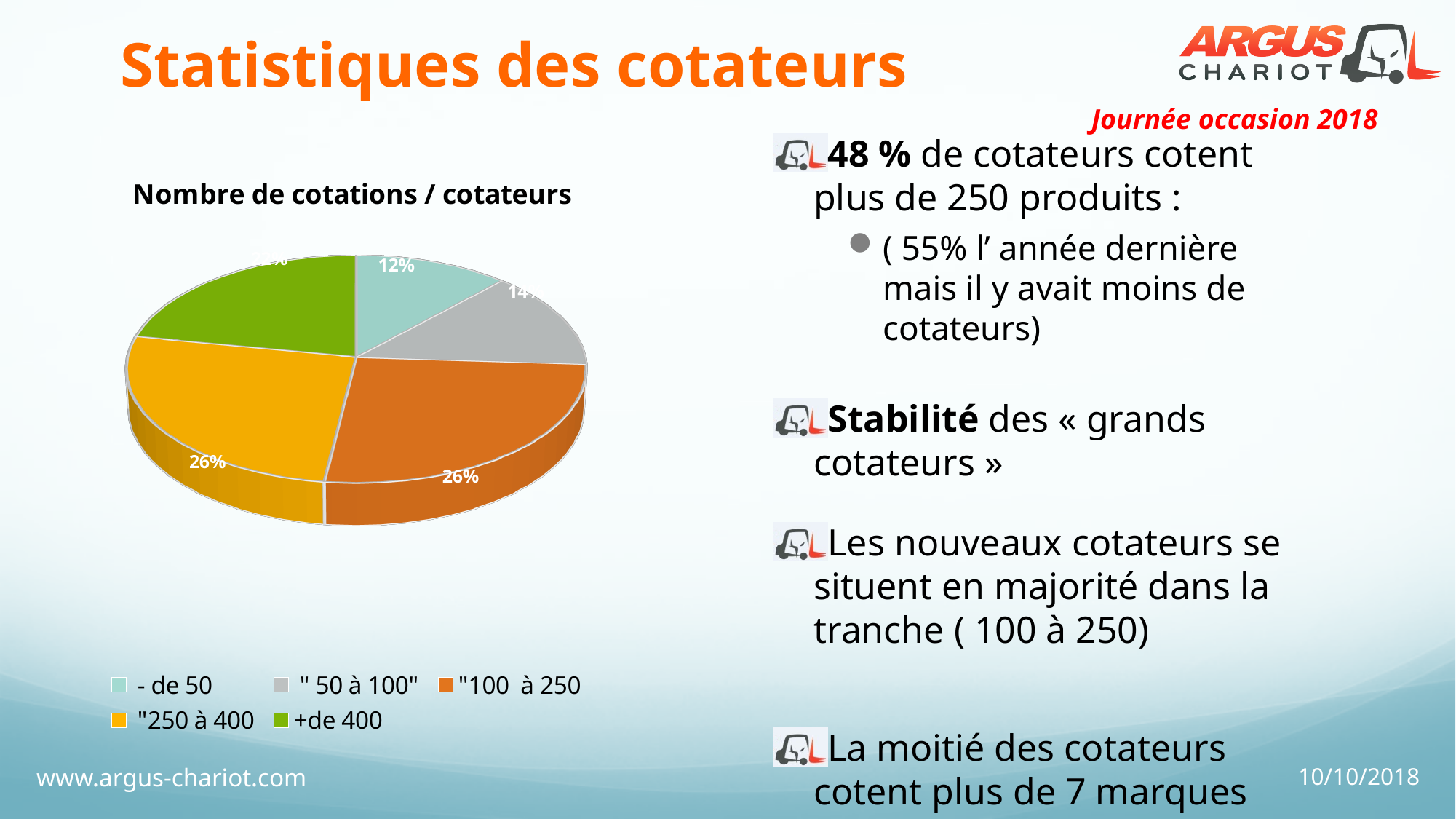
Which category is shown in green in the legend? +de 400 What is the value shown for the "50 à 100" slice? 14% What is the difference between the share for "100 à 250" and the share for "- de 50"? 14% Which is larger, the share for "- de 50" or the share for "100 à 250"? 100 à 250 What is the title of the chart? Nombre de cotations / cotateurs How many categories does the pie chart have? 5 What kind of chart is shown on the slide? pie chart What is the value shown for the "250 à 400" slice? 26% What is the value shown for the "100 à 250" slice? 26% What share of the pie does the "- de 50" category represent? 12% Which category has the smallest share of the pie? - de 50 What is the combined share of the "100 à 250" and "250 à 400" slices? 52%